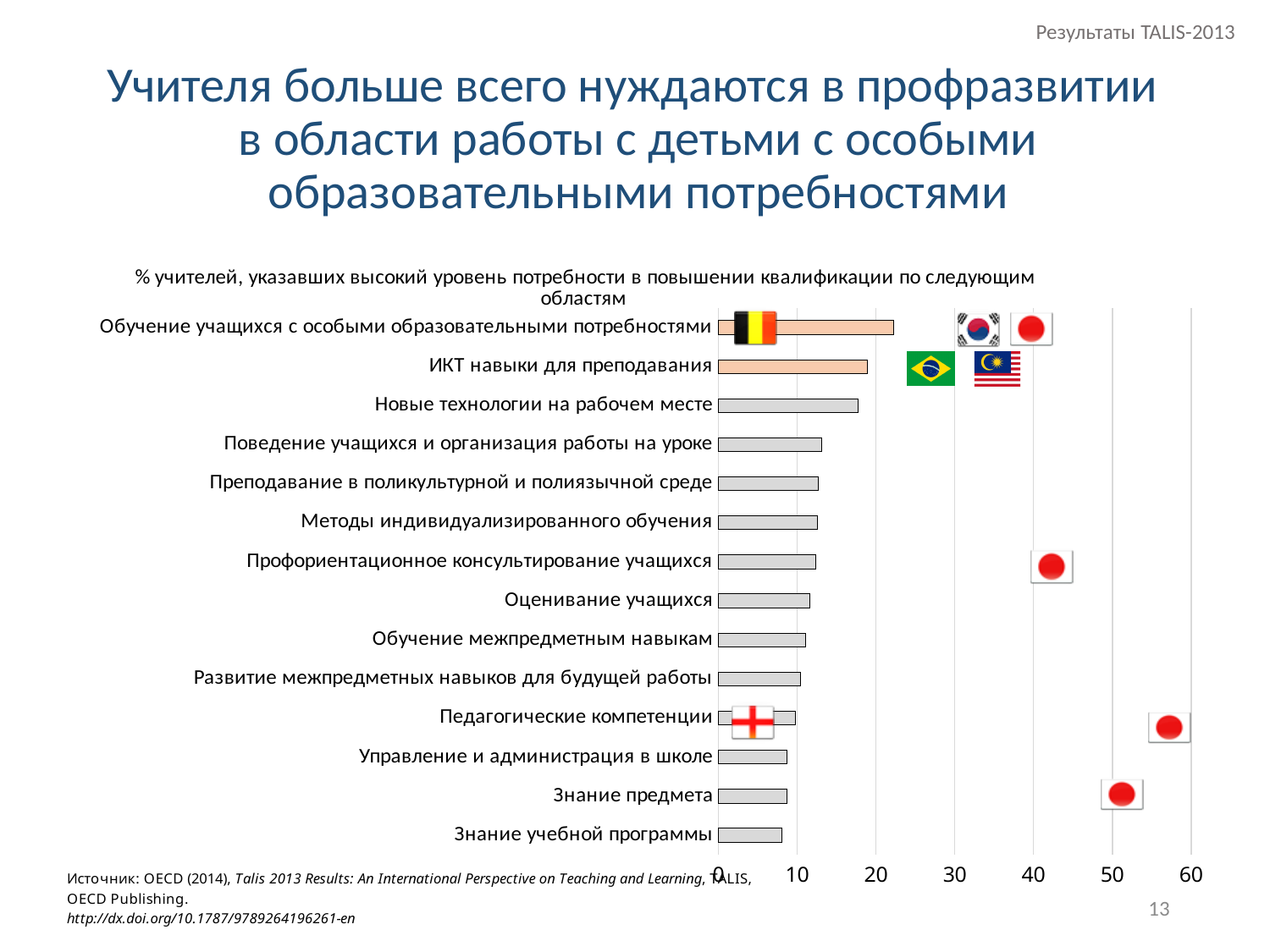
Is the value for 'Знание учебной программы' greater or less than 10? less Is the value for 'Обучение учащихся с особыми образовательными потребностями' greater or less than 20? greater What kind of chart is shown on the slide? bar chart Which area has the highest percentage of teachers indicating a high need for professional development? Обучение учащихся с особыми образовательными потребностями Which is larger: the value for 'Новые технологии на рабочем месте' or for 'Оценивание учащихся'? Новые технологии на рабочем месте Is the value for 'Новые технологии на рабочем месте' greater or less than 20? less What does the chart's subtitle say is being measured? % учителей, указавших высокий уровень потребности в повышении квалификации по следующим областям Which is larger: the value for 'Знание учебной программы' or for 'Поведение учащихся и организация работы на уроке'? Поведение учащихся и организация работы на уроке What is the highest tick value shown on the horizontal axis of the chart? 60 Which is larger: the value for 'Обучение учащихся с особыми образовательными потребностями' or for 'ИКТ навыки для преподавания'? Обучение учащихся с особыми образовательными потребностями How many categories (areas of professional development) are plotted in the chart? 14